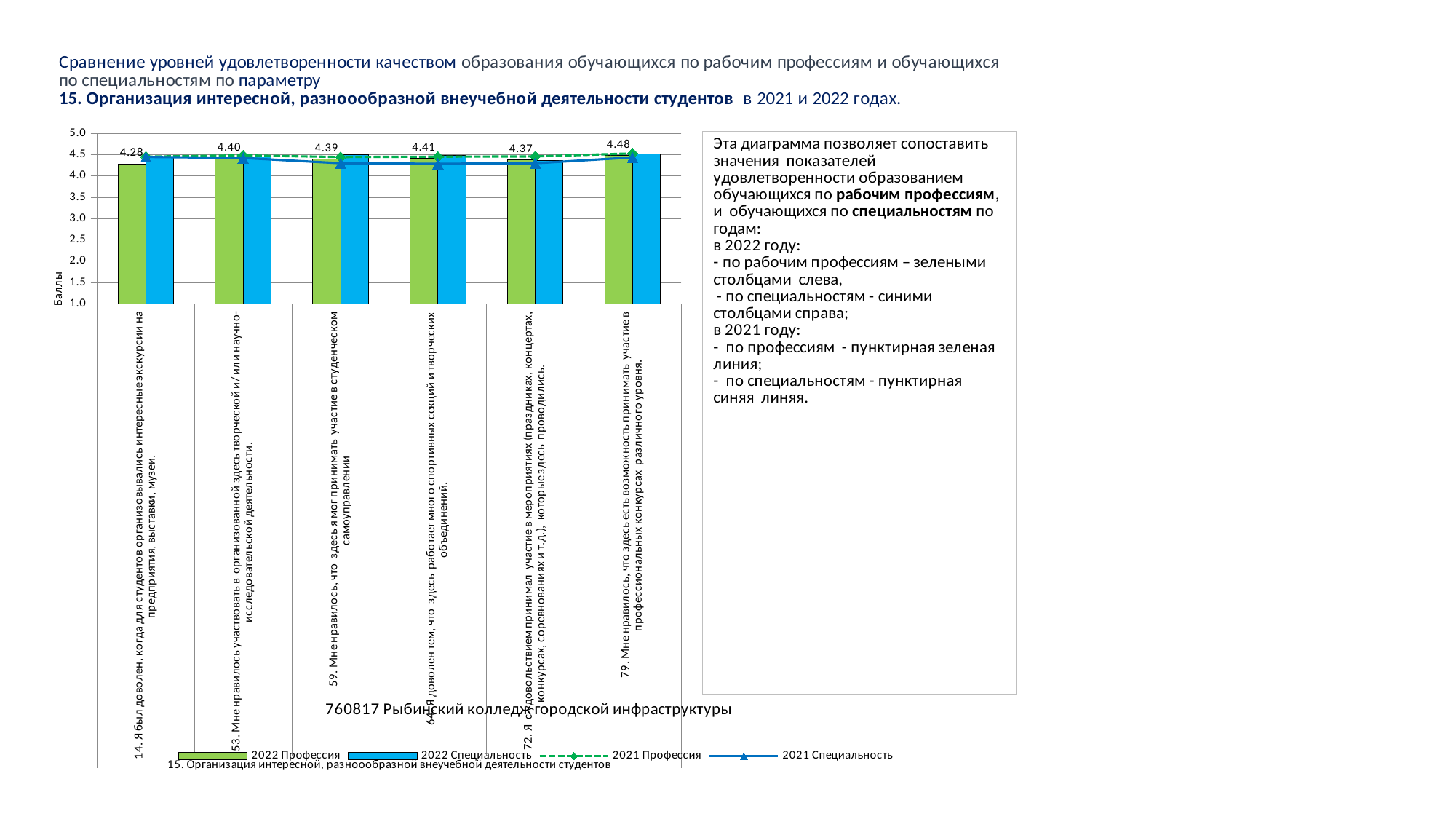
How many series does the chart legend list? 4 Which item has the highest labelled 2022 Профессия value? 79 Which labelled 2022 Профессия value is larger: item 64 or item 72? item 64 What is the labelled value for the 2022 Профессия bar for item 14 (Я был доволен, когда для студентов организовывались интересные экскурсии...)? 4.28 What is the title of the vertical axis of the chart? Баллы What is the labelled value for the 2022 Профессия bar for item 64 (Я доволен тем, что здесь работает много спортивных секций и творческих объединений)? 4.41 What is the labelled value for the 2022 Профессия bar for item 79 (Мне нравилось, что здесь есть возможность принимать участие в профессиональных конкурсах...)? 4.48 What kind of chart is shown on the slide? bar chart (with line series) Which item has the lowest labelled 2022 Профессия value? 14 What is the difference between the labelled 2022 Профессия values for item 79 and item 14? 0.20 How many categories (survey items) are shown along the x axis of the chart? 6 Is the 2022 Специальность bar for item 14 greater or less than 4.0? greater